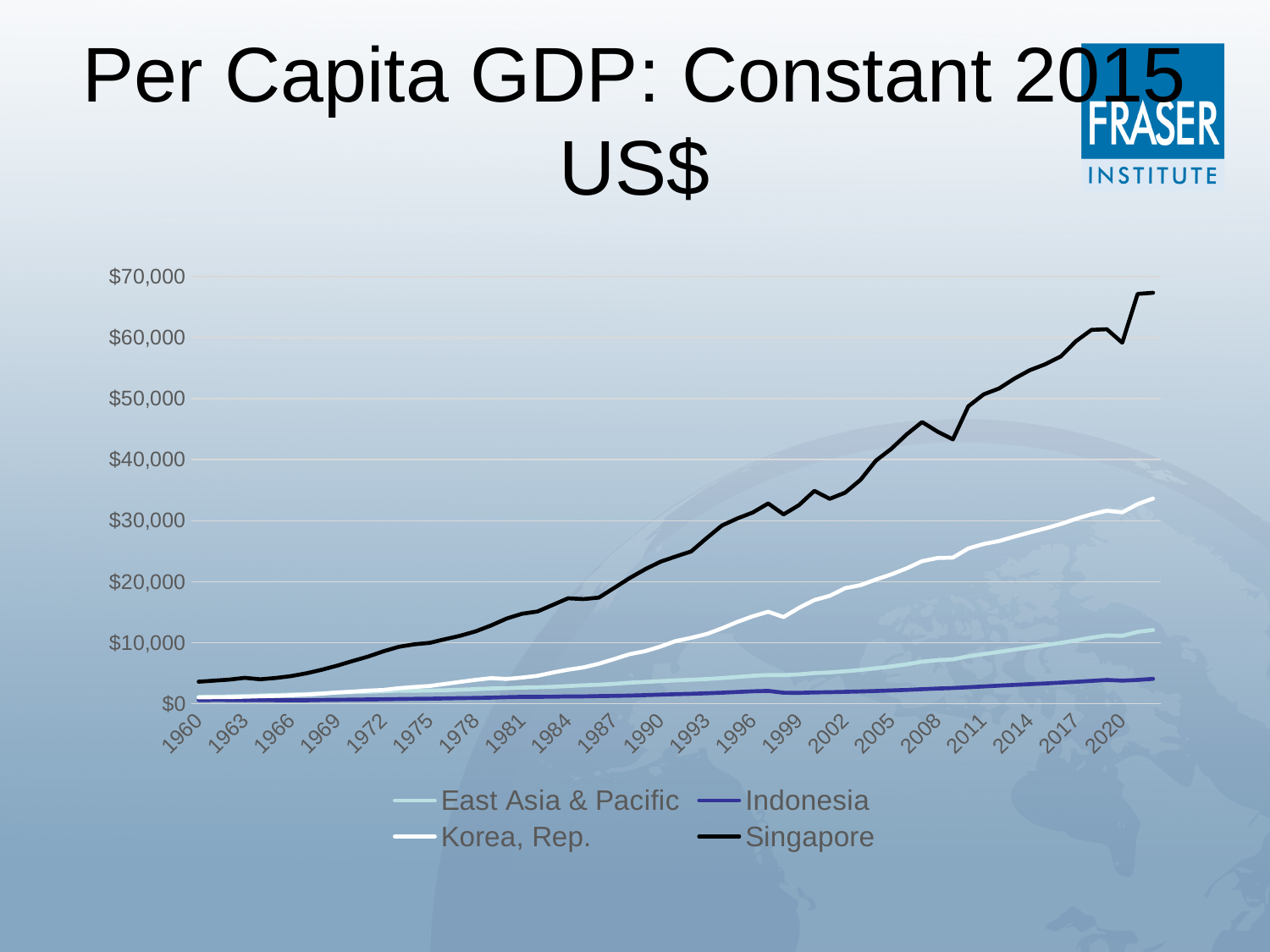
Does Singapore's per capita GDP generally rise or fall from 1960 to the 2020s? rise Is the value for Korea, Rep. in 2011 greater or less than $20,000? greater Which series has the lowest per capita GDP at the end of the period (2020s)? Indonesia Which series has the highest per capita GDP at the end of the period (2020s)? Singapore How many series does the legend list? 4 Is the value for Singapore in 2008 greater or less than $40,000? greater In 2020, which is larger: the value for East Asia & Pacific or the value for Indonesia? East Asia & Pacific In 2020, which is larger: the value for Singapore or the value for Korea, Rep.? Singapore What is the title of the chart? Per Capita GDP: Constant 2015 US$ Is the value for Indonesia in 2020 greater or less than $10,000? less What kind of chart is shown on the slide? line chart Which series is drawn with the black line? Singapore